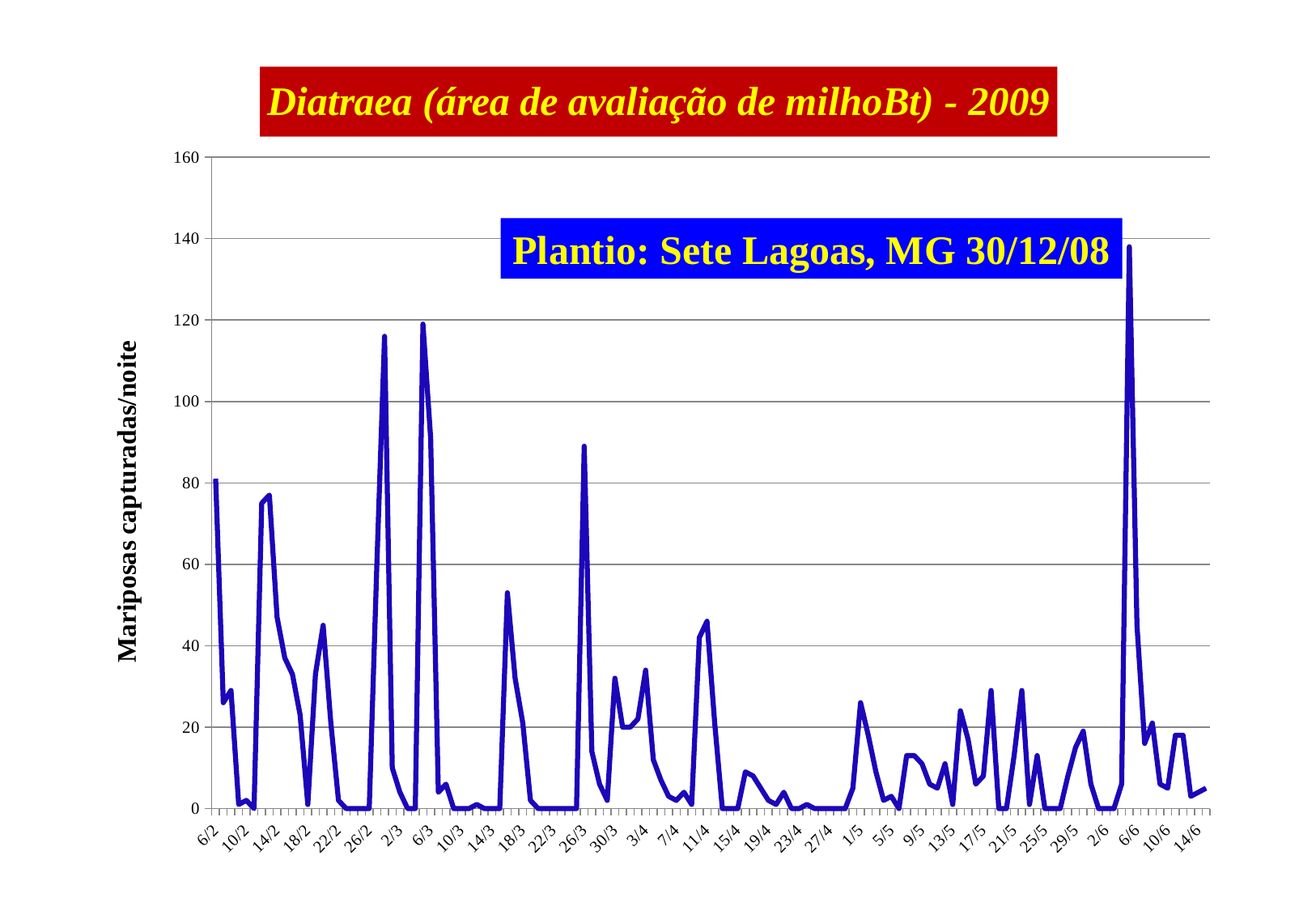
Is the peak near 26/3 greater or less than 100? less Is the peak near 11/4 greater or less than 60? less What kind of chart is shown on the slide? line chart Is the value on 6/2, the first date on the x axis, greater or less than 60? greater What is the label of the vertical axis? Mariposas capturadas/noite What is the title of the chart? Diatraea (área de avaliação de milhoBt) - 2009 Does the line rise or fall between 6/2 and 10/2? fall In which month does the highest peak of the line occur? June